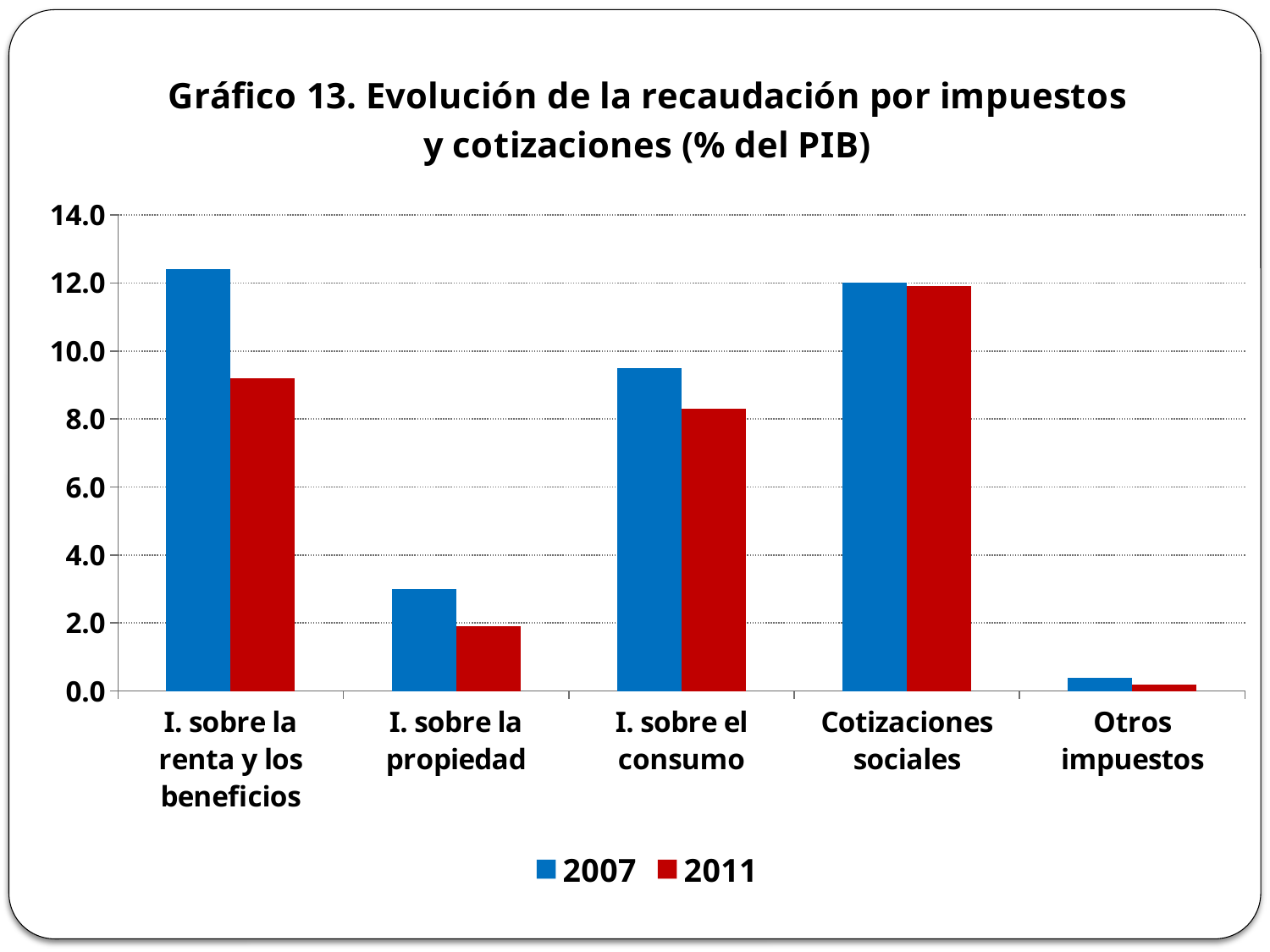
In 2007, which is larger: I. sobre el consumo or Cotizaciones sociales? Cotizaciones sociales For I. sobre la renta y los beneficios, which year has the larger value, 2007 or 2011? 2007 Which category has the highest value for 2011? Cotizaciones sociales What kind of chart is shown on the slide? bar chart Which category has the lowest value for 2007? Otros impuestos Is the value for I. sobre la renta y los beneficios in 2007 greater or less than 10.0? greater How many series does the legend list? 2 Is the value for Otros impuestos in 2007 greater or less than 2.0? less Which colour represents the 2011 series? red Is the value for Cotizaciones sociales in 2011 greater or less than 10.0? greater How many categories are shown on the x axis? 5